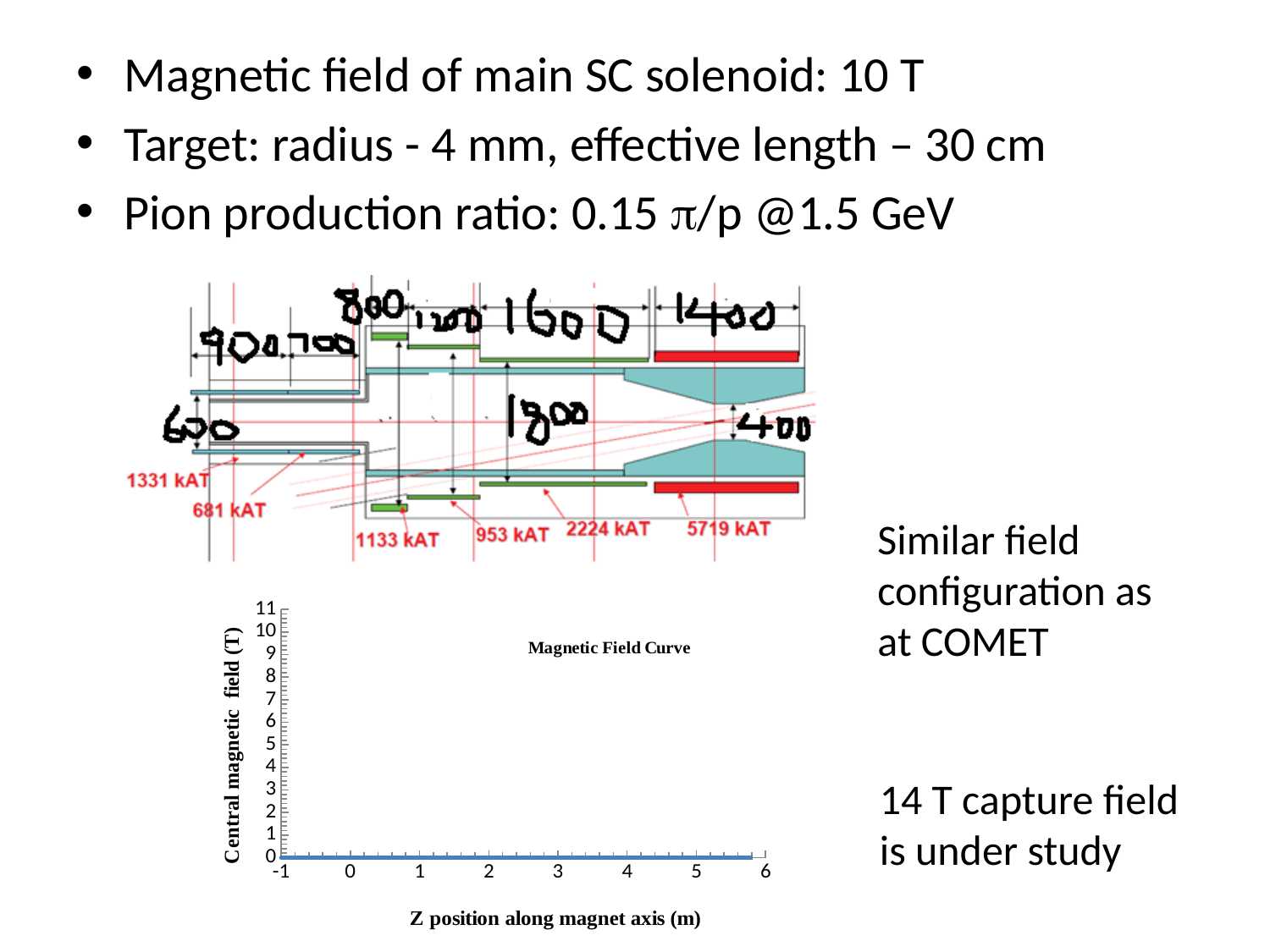
What kind of chart is the Magnetic Field Curve chart? line chart What is the label of the vertical axis of the Magnetic Field Curve chart? Central magnetic field (T) What is the title of the chart at the bottom of the slide? Magnetic Field Curve In the Magnetic Field Curve chart, is the plotted value at Z = 1 m greater or less than 10? less In the Magnetic Field Curve chart, is the plotted value at Z = 3 m greater or less than 5? less